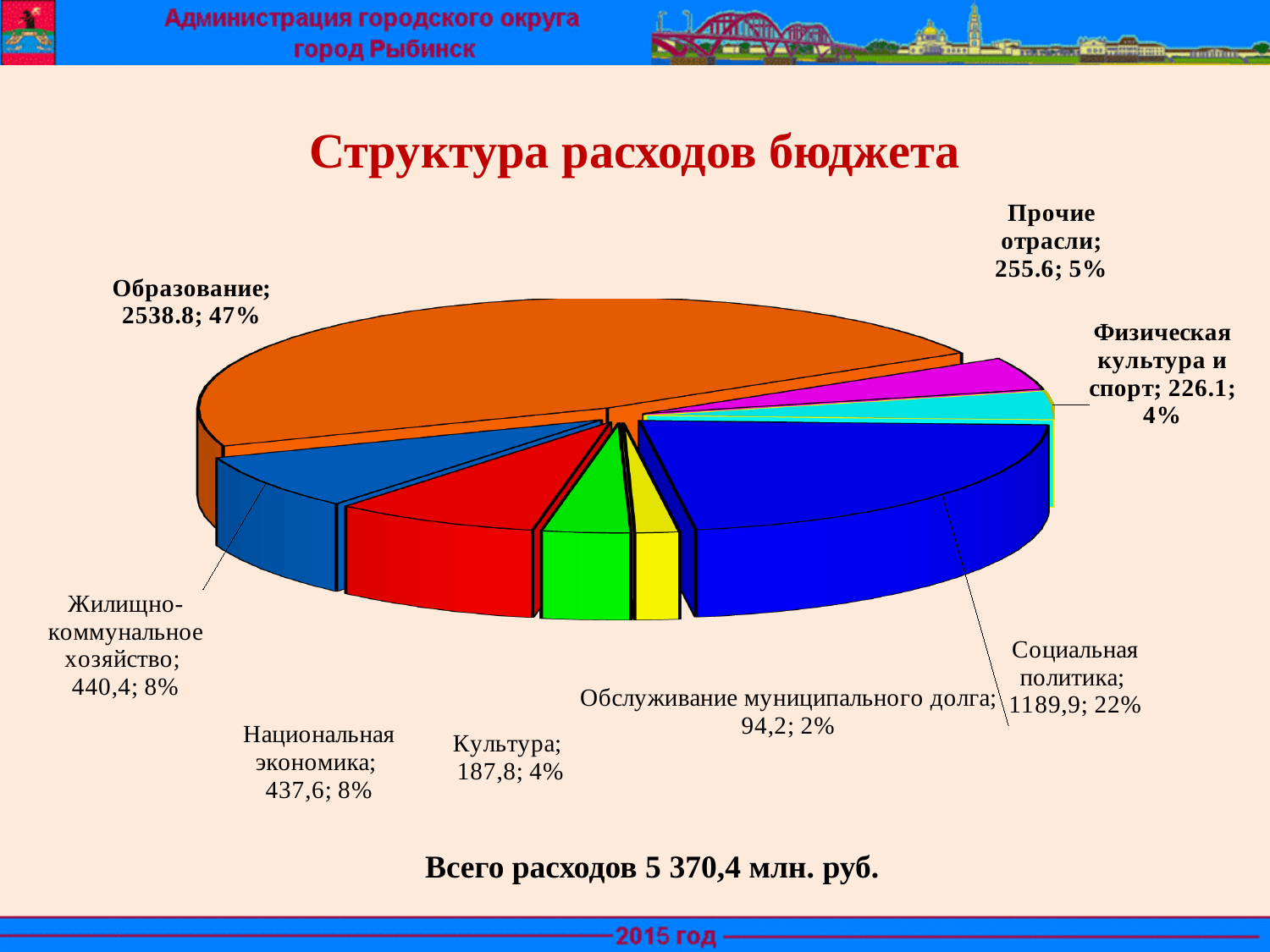
What is the value shown for Прочие отрасли? 255.6 What total expenditure is stated below the chart? 5 370,4 млн. руб. How many categories are shown in the pie chart? 8 What is the title of the chart? Структура расходов бюджета Which is larger, the value for Социальная политика or the value for Национальная экономика? Социальная политика What kind of chart is shown on the slide? pie chart Which category has the largest slice of the pie? Образование What is the value shown for Образование? 2538.8 What share of the pie does Социальная политика take? 22% Which category has the smallest slice of the pie? Обслуживание муниципального долга What is the value shown for Обслуживание муниципального долга? 94,2 What share of the pie does Физическая культура и спорт take? 4%